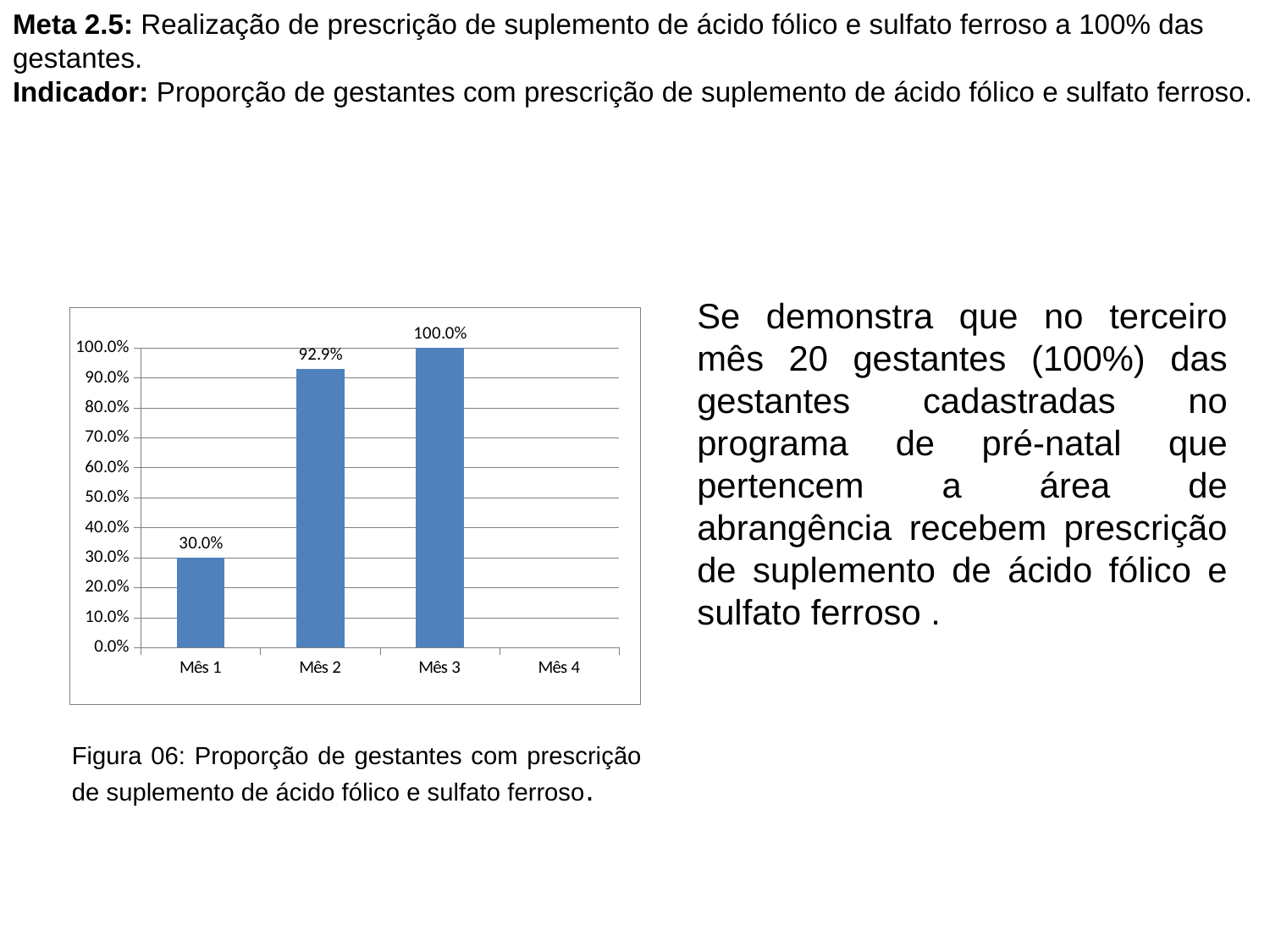
Do the values rise or fall from Mês 1 to Mês 3? rise What kind of chart is shown? bar chart Is the value for Mês 2 greater or less than 90.0%? greater What is the difference between the values for Mês 3 and Mês 1? 70.0% Which is larger, the value for Mês 1 or the value for Mês 2? Mês 2 How many categories are shown on the x axis? 4 Which month has the highest value? Mês 3 What is the value for Mês 3? 100.0% What is the value for Mês 2? 92.9% What is the value for Mês 1? 30.0% Which month with a plotted bar has the lowest value? Mês 1 What is the difference between the values for Mês 2 and Mês 1? 62.9%